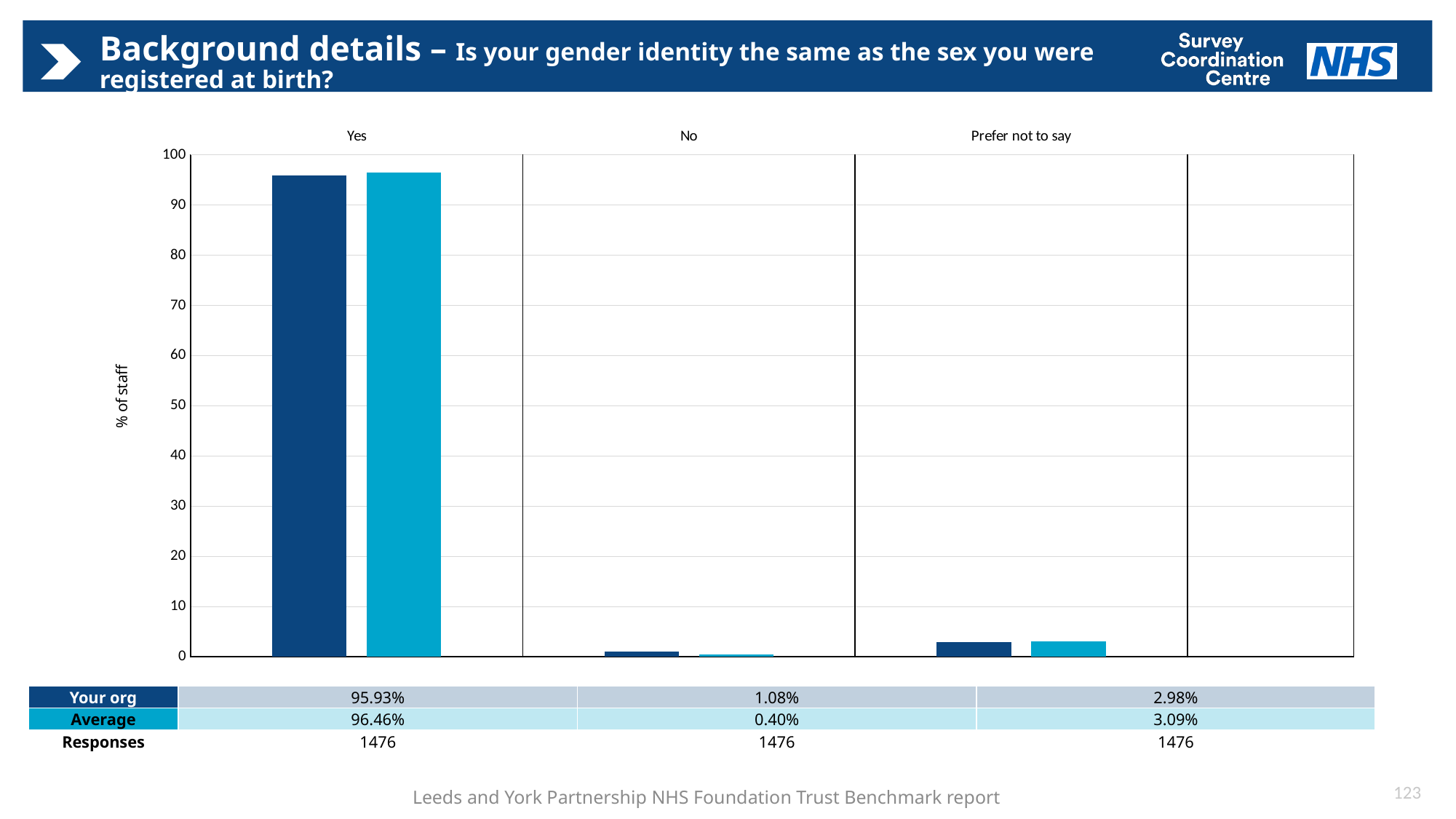
What is the 'Average' value for 'No'? 0.40% Which category has the highest 'Your org' value? Yes What is the difference between the 'Your org' and 'Average' values for 'No'? 0.68% What type of chart is shown on the slide? Bar chart How many responses are recorded for the 'Yes' category? 1476 What is the 'Average' value for 'Prefer not to say'? 3.09% For 'Yes', which is larger: the 'Your org' value or the 'Average' value? Average What is the 'Your org' value for 'Prefer not to say'? 2.98% Is the 'Your org' value for 'Yes' greater or less than 90? greater How many response categories are shown on the chart? 3 Which category has the lowest 'Average' value? No What is the 'Your org' value for 'Yes'? 95.93%